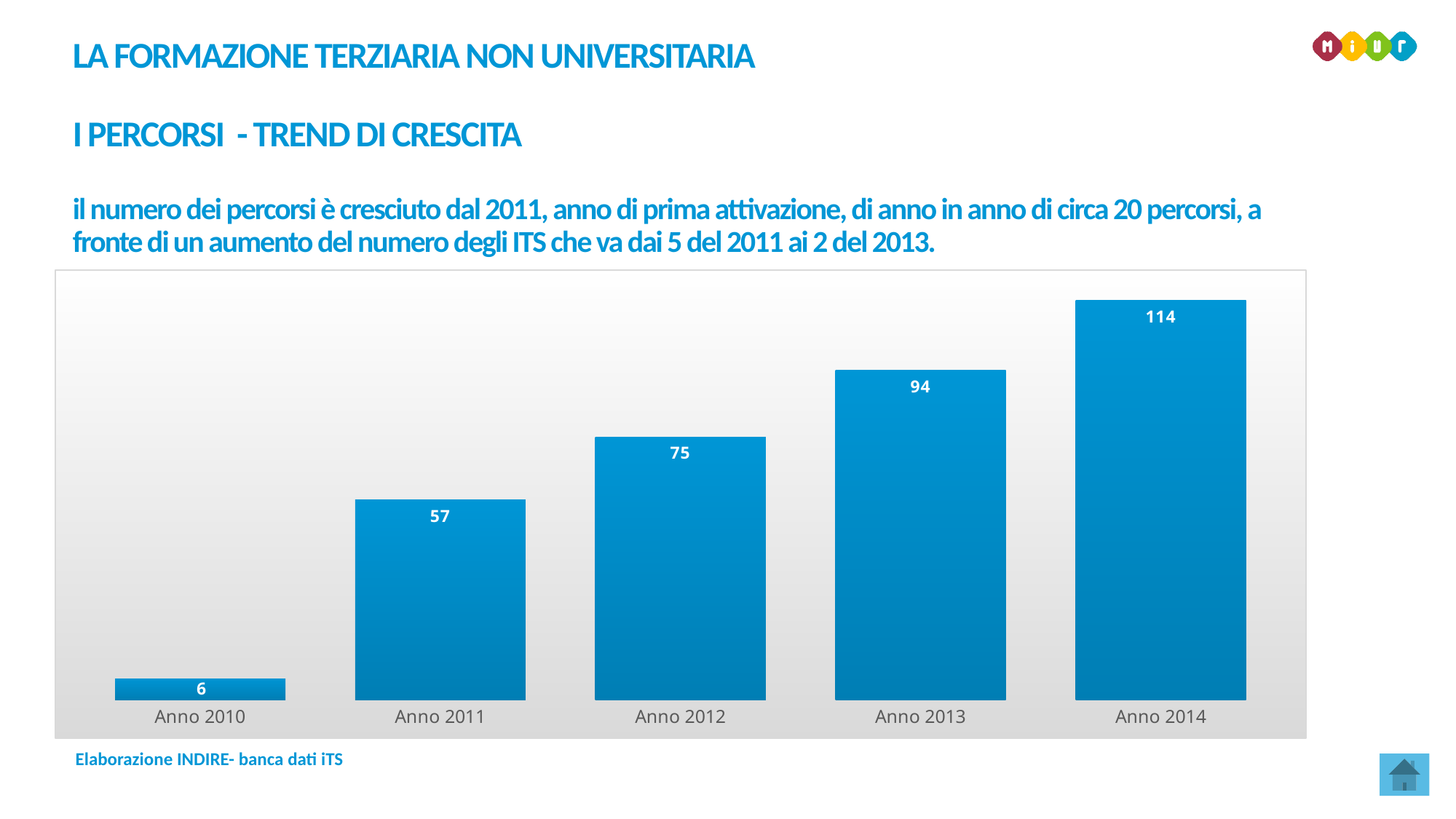
What is the difference between the values for Anno 2012 and Anno 2011? 18 Which year has the highest value? Anno 2014 What is the value for Anno 2013? 94 How many years are shown on the x axis? 5 What kind of chart is shown on the slide? Bar chart What is the value for Anno 2011? 57 What is the value for Anno 2010? 6 Which is larger, the value for Anno 2012 or the value for Anno 2013? Anno 2013 What is the difference between the values for Anno 2014 and Anno 2013? 20 What is the source noted below the chart? Elaborazione INDIRE- banca dati iTS Do the values rise or fall from Anno 2010 to Anno 2014? Rise Which year has the lowest value? Anno 2010